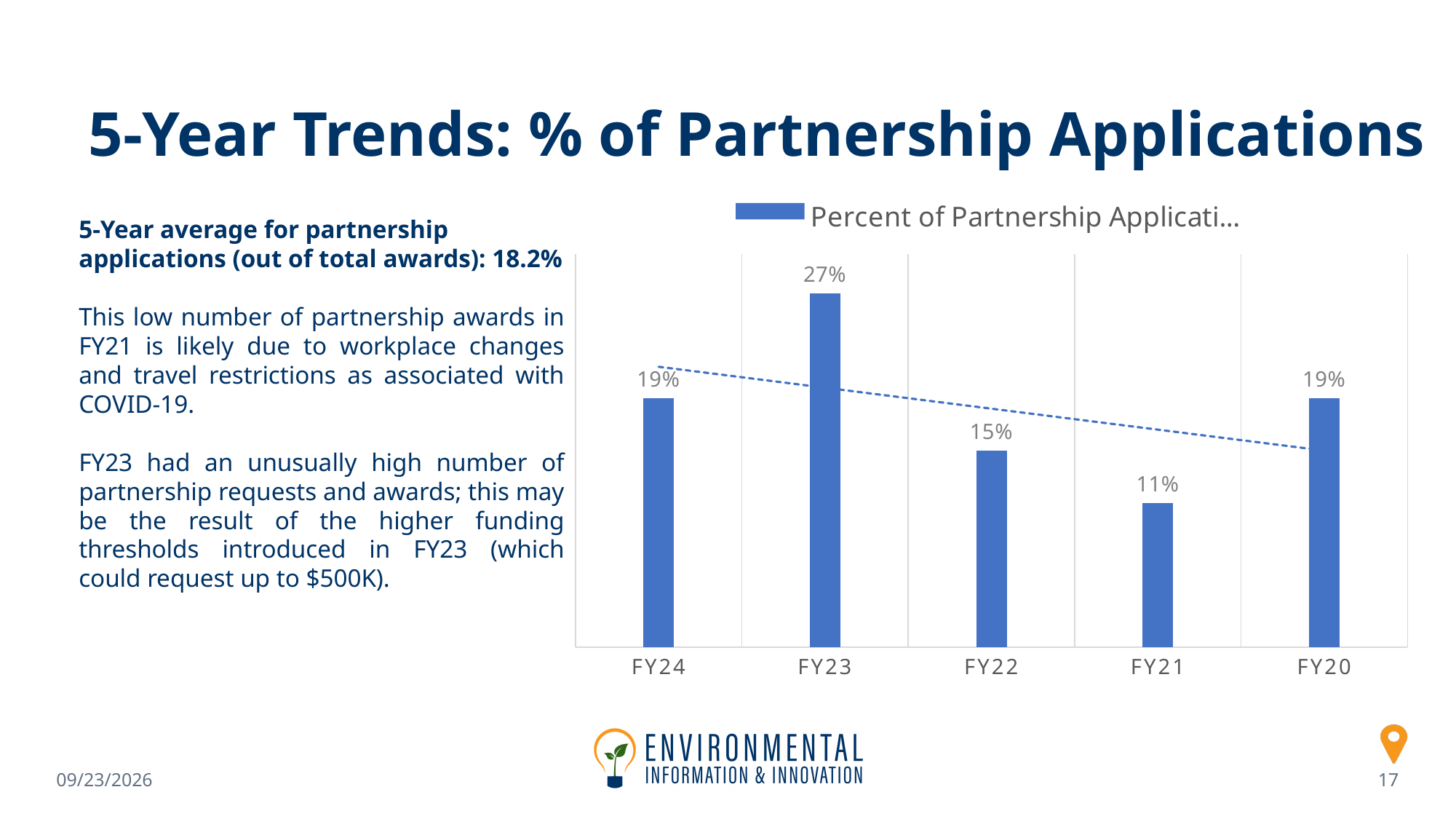
What is the difference between the values for FY24 and FY22? 4% What is the difference between the values for FY23 and FY21? 16% What kind of chart is shown on the slide? Bar chart How many fiscal years are shown on the x axis? 5 Which fiscal year has the highest percentage of partnership applications? FY23 Which fiscal year has the lowest percentage of partnership applications? FY21 What is the value for FY23? 27% How many series does the legend list? 1 Which is larger, the value for FY22 or the value for FY20? FY20 What is the value for FY21? 11% What is the value for FY24? 19% What is the value for FY22? 15%